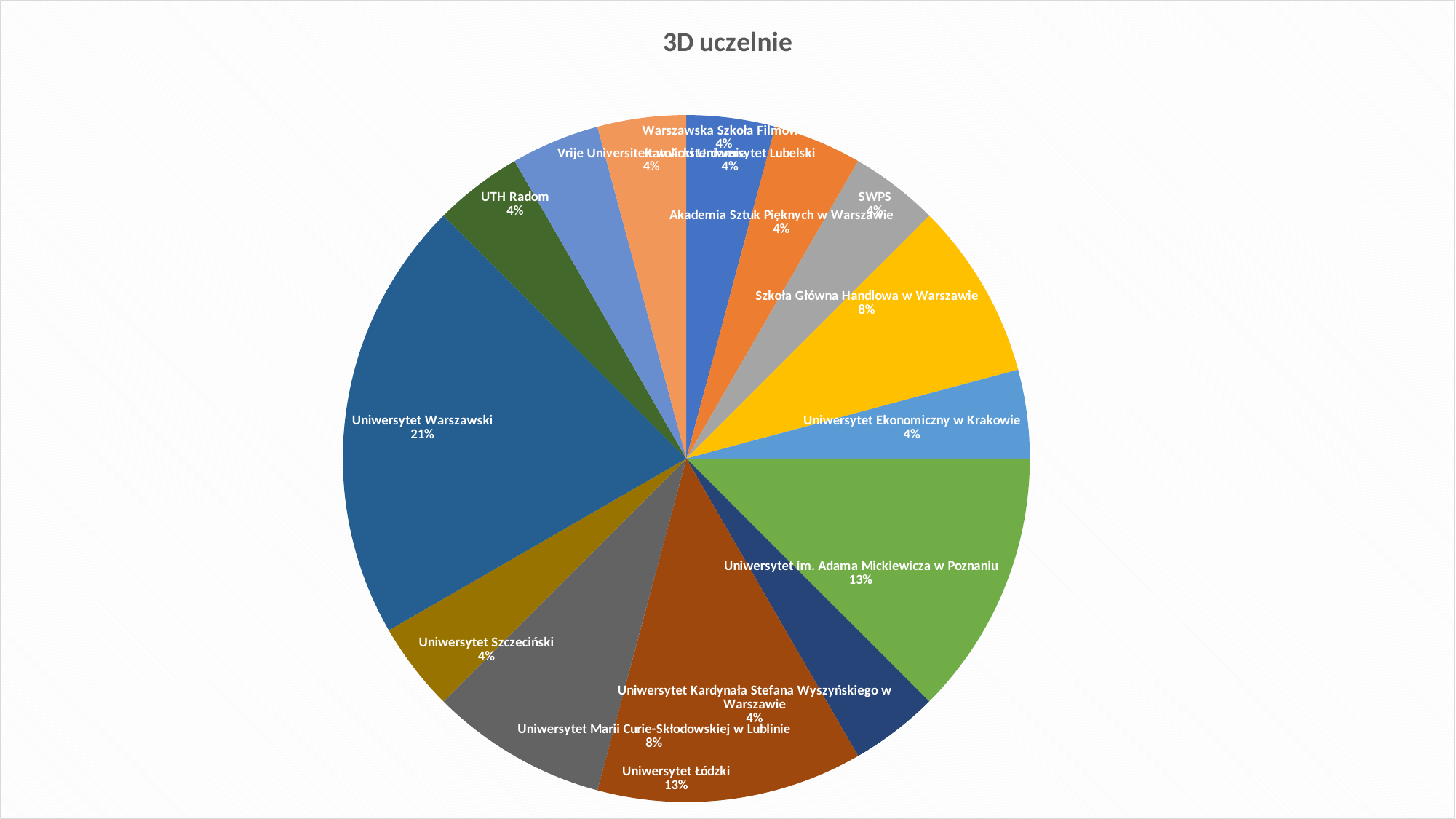
What percentage is shown for Uniwersytet Szczeciński? 4% What share of the pie does Uniwersytet Warszawski have? 21% What percentage is shown for Szkoła Główna Handlowa w Warszawie? 8% How many slices does the pie chart have? 14 What is the title of the chart? 3D uczelnie What is the difference in percentage points between Uniwersytet Warszawski and Uniwersytet Łódzki? 8 Which has a larger share: Szkoła Główna Handlowa w Warszawie or Uniwersytet Ekonomiczny w Krakowie? Szkoła Główna Handlowa w Warszawie What percentage is shown for Uniwersytet im. Adama Mickiewicza w Poznaniu? 13% What percentage is shown for UTH Radom? 4% Which university has the largest slice of the pie? Uniwersytet Warszawski What kind of chart is shown on the slide? pie chart What percentage is shown for Uniwersytet Marii Curie-Skłodowskiej w Lublinie? 8%